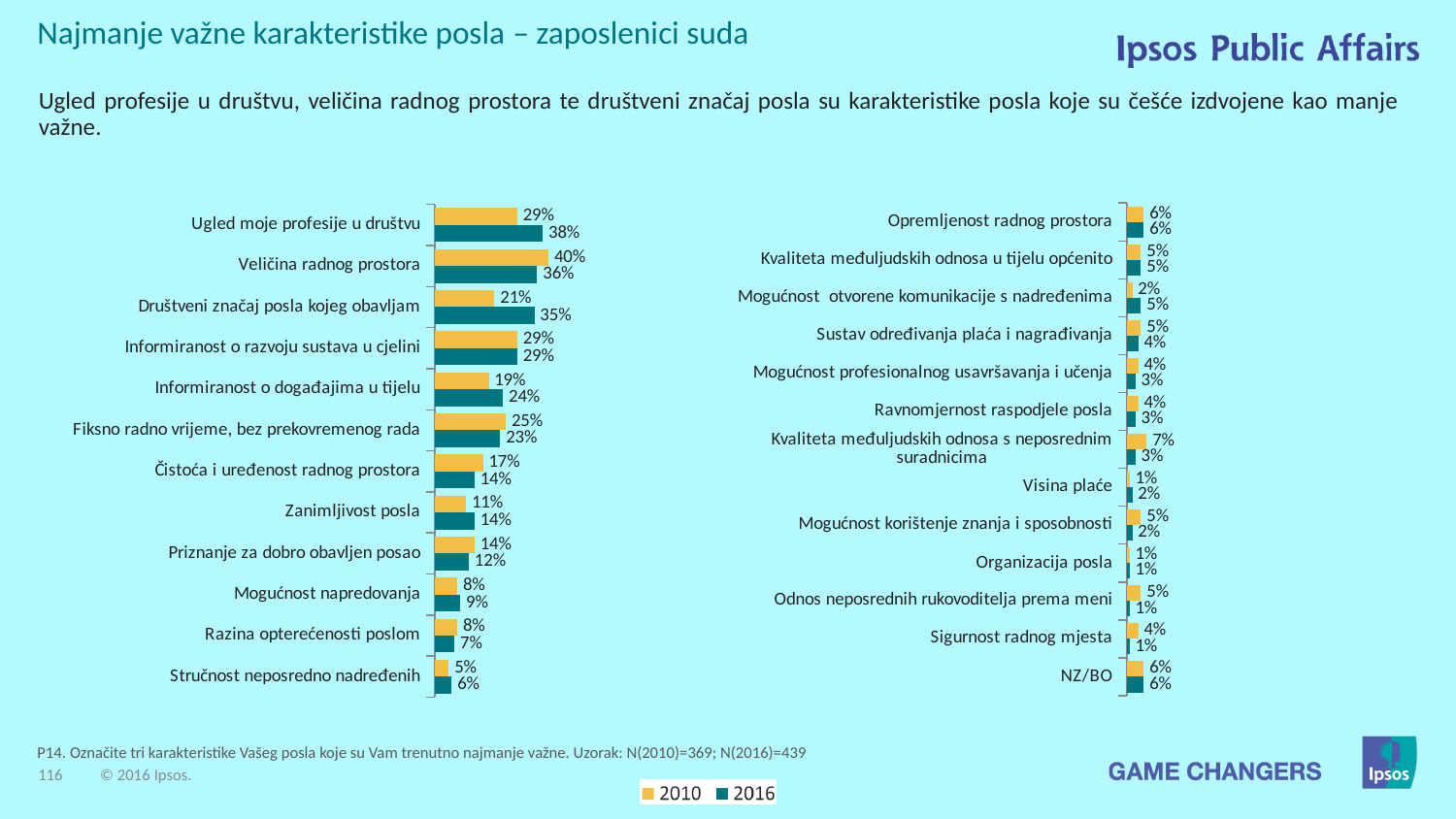
In the right chart, what is the 2016 value for Mogućnost otvorene komunikacije s nadređenima? 5% What type of chart is the left chart? Bar chart In the right chart, what is the 2010 value for Kvaliteta međuljudskih odnosa s neposrednim suradnicima? 7% In the left chart, which is larger for Fiksno radno vrijeme, bez prekovremenog rada: the 2010 value or the 2016 value? 2010 In the left chart, what is the 2010 value for Veličina radnog prostora? 40% In the left chart, what is the 2016 value for Ugled moje profesije u društvu? 38% How many series does the legend list? 2 How many categories are shown in the right chart? 13 In the left chart, which category has the highest 2016 value? Ugled moje profesije u društvu In the left chart, which category has the lowest 2010 value? Stručnost neposredno nadređenih How many categories are shown in the left chart? 12 In the left chart, what is the difference between the 2016 and 2010 values for Društveni značaj posla kojeg obavljam? 14%